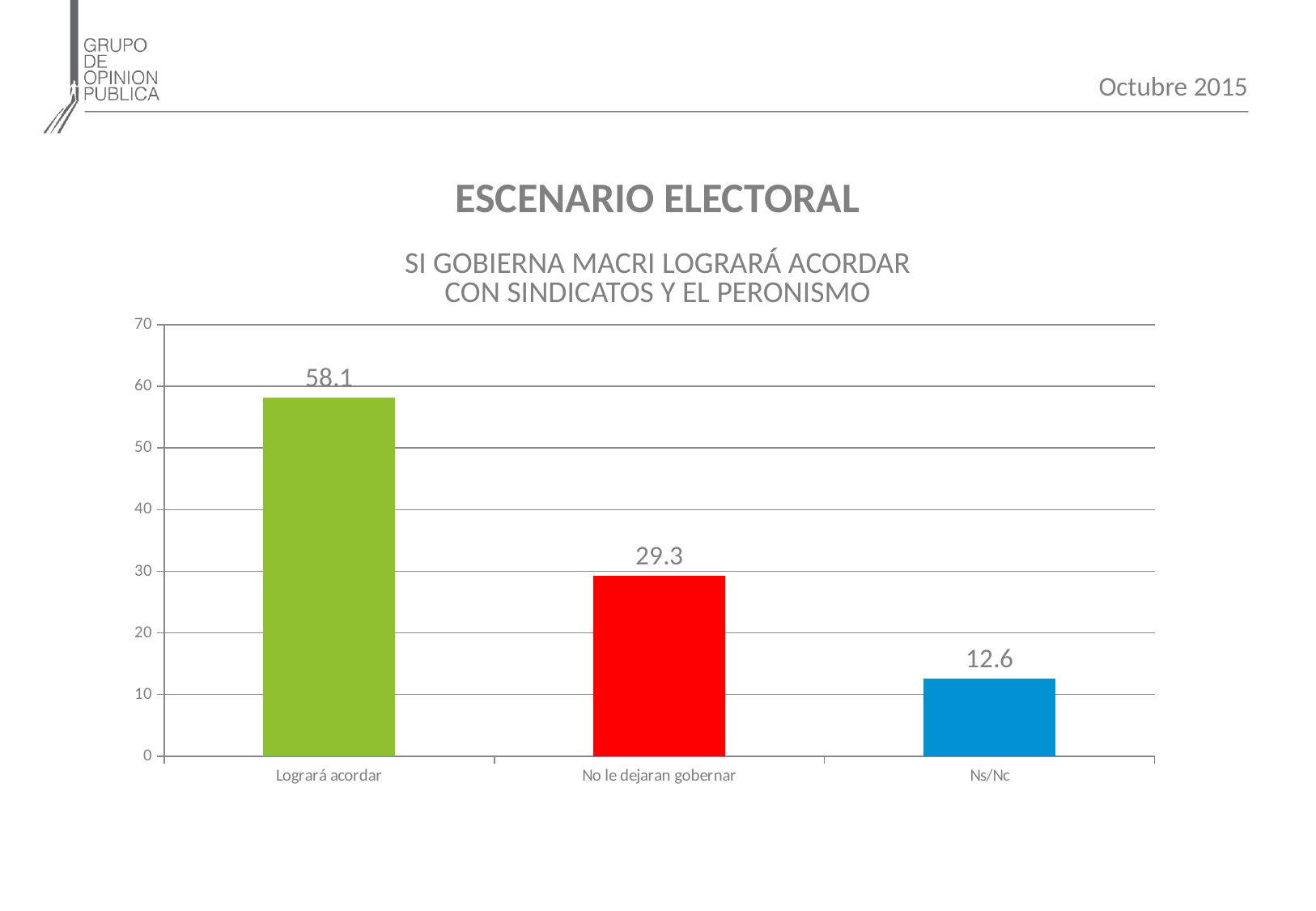
Is the value for "Logrará acordar" greater or less than 50? greater Which category has the highest value? Logrará acordar What is the value for "No le dejaran gobernar"? 29.3 What is the value for "Ns/Nc"? 12.6 What is the difference between the values for "Logrará acordar" and "No le dejaran gobernar"? 28.8 What is the value for "Logrará acordar"? 58.1 What is the difference between the values for "No le dejaran gobernar" and "Ns/Nc"? 16.7 Which is larger, the value for "No le dejaran gobernar" or the value for "Ns/Nc"? No le dejaran gobernar What colour is the bar for "Ns/Nc"? blue What kind of chart is shown on the slide? bar chart Which category has the lowest value? Ns/Nc How many categories are shown on the x axis? 3